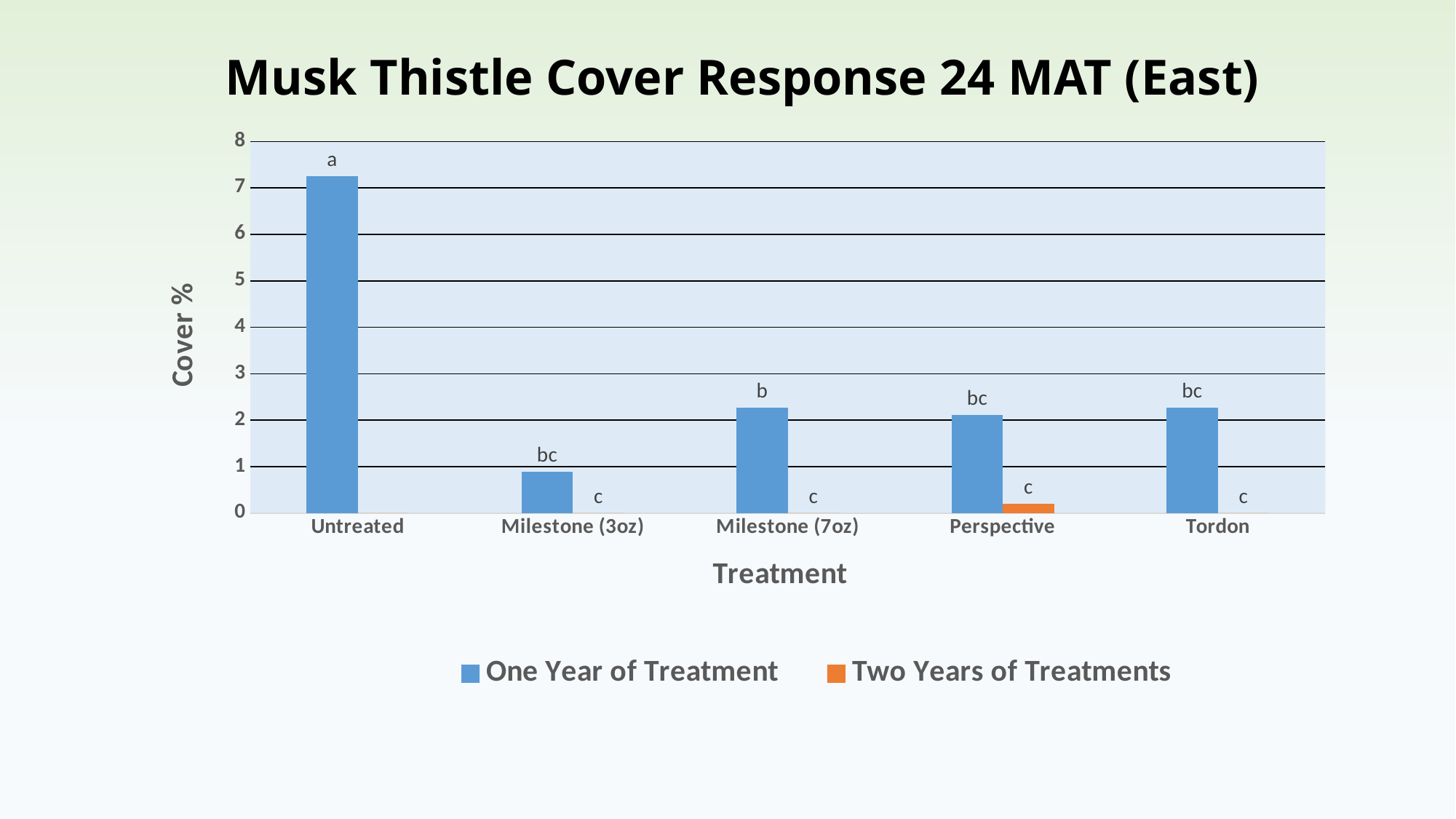
How many series does the legend list? 2 Is the One Year of Treatment value for Milestone (7oz) greater or less than 2? greater What is the title of the chart? Musk Thistle Cover Response 24 MAT (East) Is the One Year of Treatment value for Milestone (3oz) greater or less than 1? less What kind of chart is shown on the slide? bar chart Which treatment has the lowest cover % for One Year of Treatment? Milestone (3oz) Is the One Year of Treatment value for Untreated greater or less than 6? greater Which has a larger One Year of Treatment cover %, Perspective or Milestone (3oz)? Perspective How many treatment categories are shown on the x axis? 5 Which treatment has the highest cover % for One Year of Treatment? Untreated Which has a larger One Year of Treatment cover %, Untreated or Milestone (7oz)? Untreated